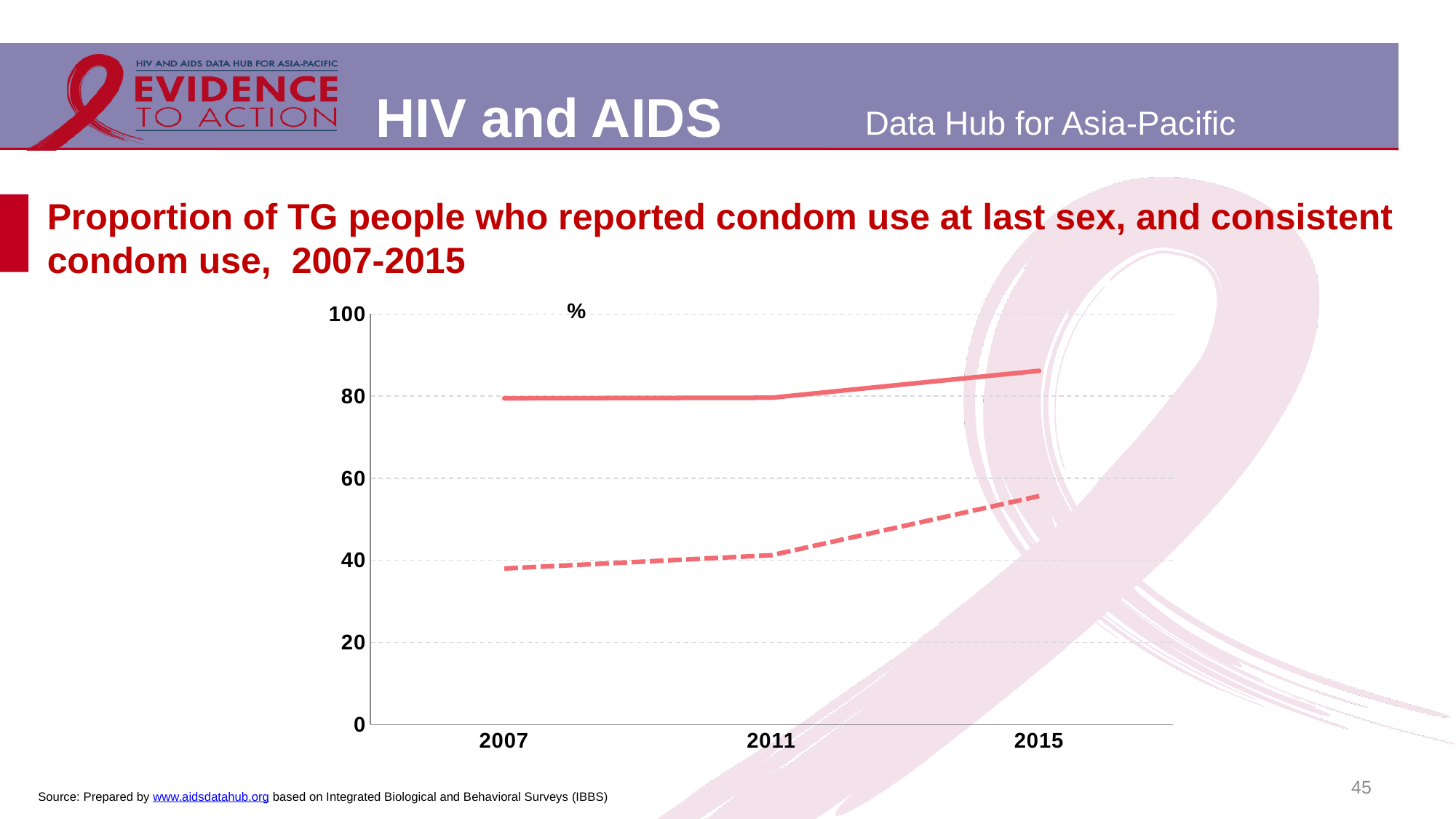
In which year does the dashed line reach its highest value? 2015 What kind of chart is shown on the slide? line chart In which year does the dashed line have its lowest value? 2007 Is the value of the dashed line in 2007 greater or less than 40? less Does the dashed line rise or fall from 2007 to 2015? rise Is the value of the solid line in 2015 greater or less than 80? greater How many years are marked on the x axis of the chart? 3 How many lines are plotted on the chart? 2 Is the value of the dashed line in 2015 greater or less than 60? less In 2015, which line has the higher value, the solid line or the dashed line? solid line What unit is indicated at the top of the y axis? % Does the solid line rise or fall from 2011 to 2015? rise